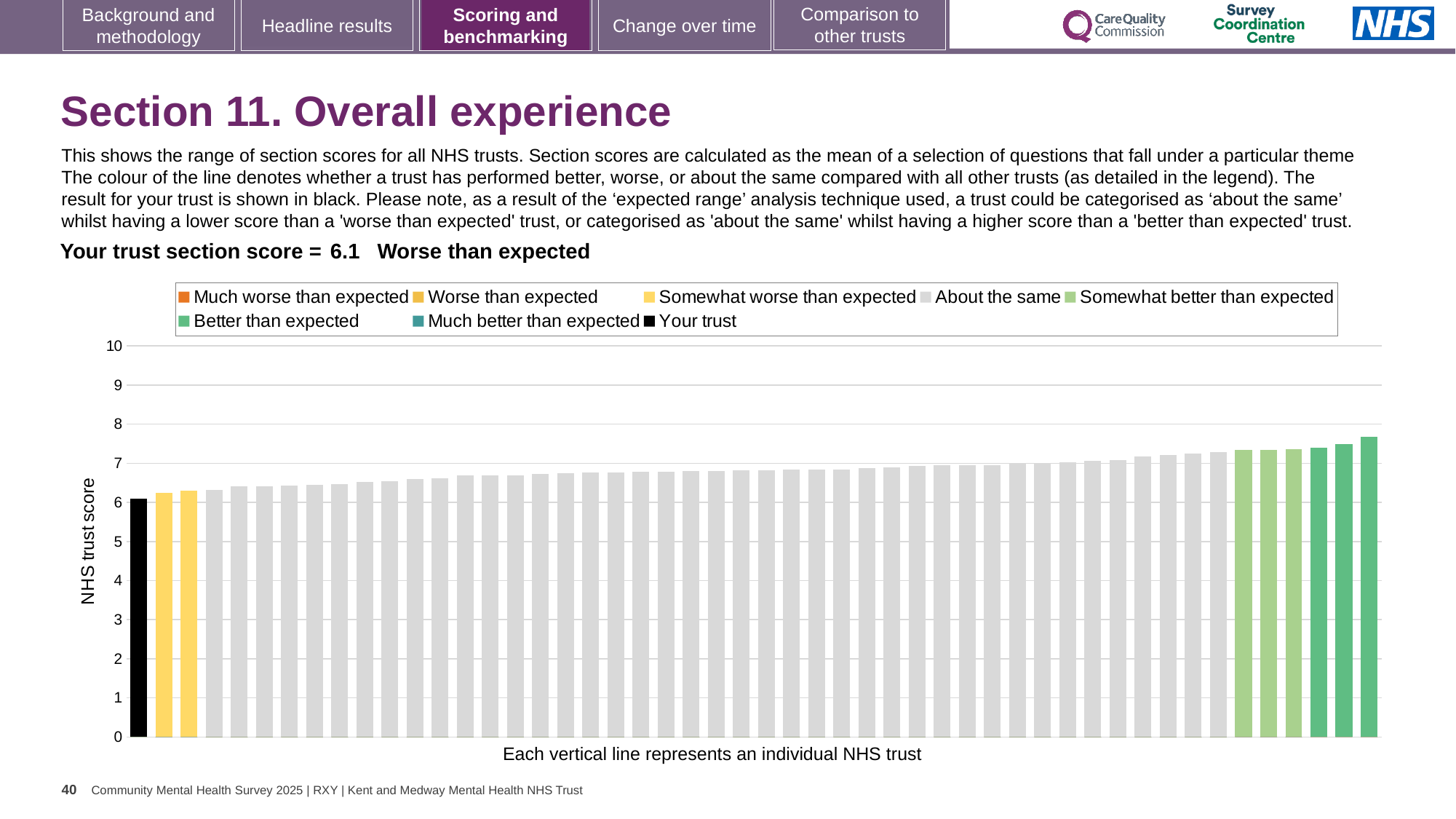
Is the value of the tallest bar in the chart greater or less than 7? greater How many entries does the chart legend list? 8 What is the section score for your trust shown on the slide? 6.1 How many bars are coloured as 'Somewhat better than expected' (light green)? 3 Is the value of the black 'Your trust' bar greater or less than 7? less How many bars are coloured as 'Somewhat worse than expected' (yellow)? 2 Do the bar values rise or fall from left to right across the chart? rise What colour is the bar representing your trust? Black What is the title of the vertical axis? NHS trust score Which bar is the lowest in the chart? Your trust How many bars are coloured as 'Better than expected' (green)? 3 What kind of chart is shown on the slide? Bar chart